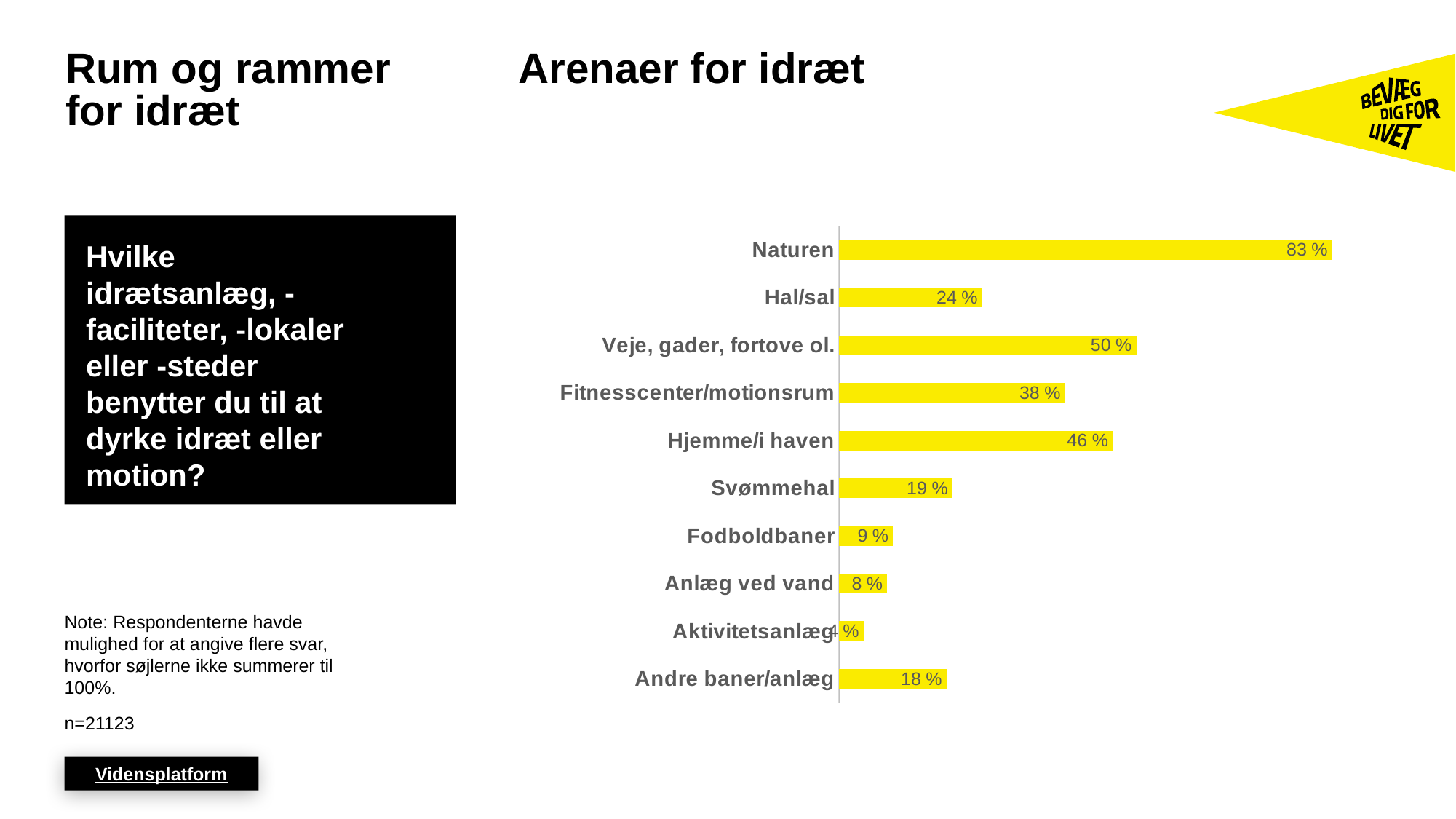
What kind of chart is shown on the slide? Bar chart How many categories are shown in the chart? 10 What is the difference between the values for Hjemme/i haven and Hal/sal? 22 % Which category has the lowest value? Aktivitetsanlæg What is the value for Andre baner/anlæg? 18 % What is the value for Svømmehal? 19 % What is the value for Naturen? 83 % Which is larger, the value for Fodboldbaner or the value for Anlæg ved vand? Fodboldbaner Which category has the highest value? Naturen What is the difference between the values for Naturen and Veje, gader, fortove ol.? 33 % What is the value for Fitnesscenter/motionsrum? 38 % What is the title of the chart? Arenaer for idræt